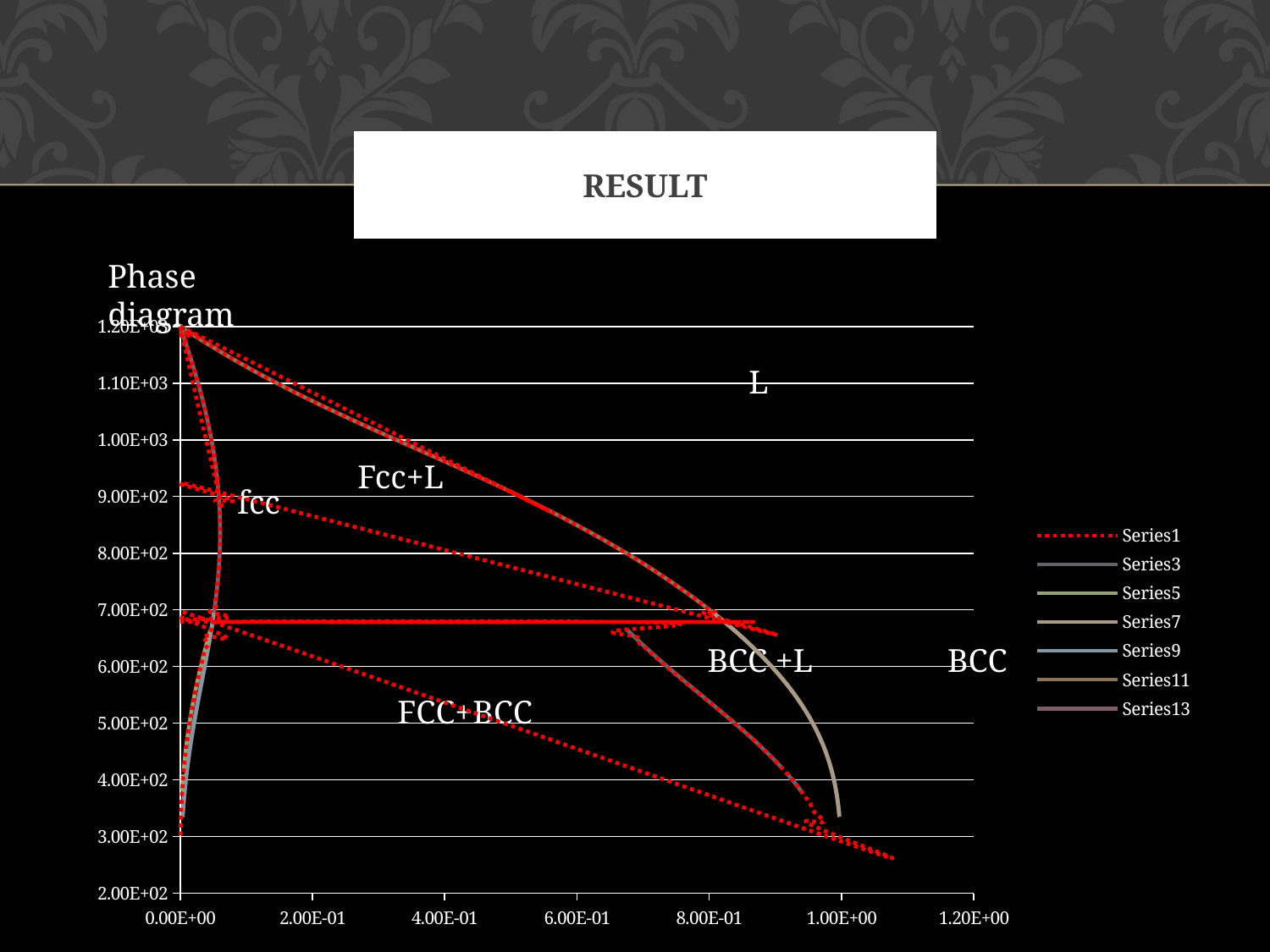
What is the highest value shown on the horizontal axis? 1.20E+00 Is the value of the nearly horizontal red line across the middle of the chart greater or less than 8.00E+02? less What is the lowest value shown on the vertical axis? 2.00E+02 How many series does the legend list? 7 What kind of chart is shown on the slide? line chart Which phase region label appears in the upper right area of the chart? L Is the value of the nearly horizontal red line across the middle of the chart greater or less than 6.00E+02? greater